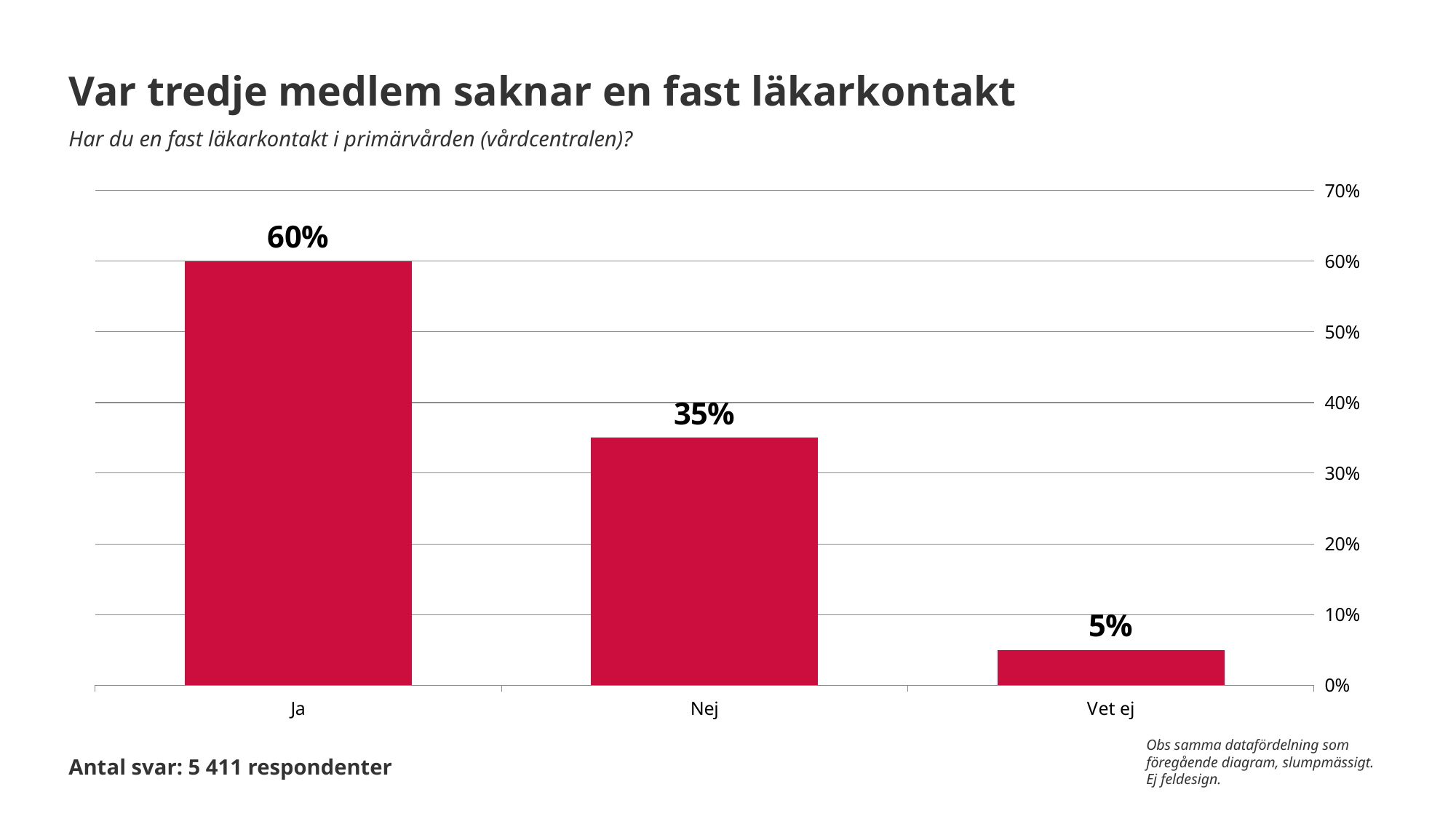
Which category has the highest value? Ja Is the value for "Nej" greater or less than 40%? less What is the value for "Ja"? 60% What is the title of the slide? Var tredje medlem saknar en fast läkarkontakt What kind of chart is shown on the slide? bar chart What is the value for "Vet ej"? 5% What is the value for "Nej"? 35% Which is larger, the value for "Nej" or the value for "Vet ej"? Nej What is the difference between the values for "Ja" and "Nej"? 25% What is the difference between the values for "Nej" and "Vet ej"? 30% How many categories are shown on the x axis? 3 Which category has the lowest value? Vet ej